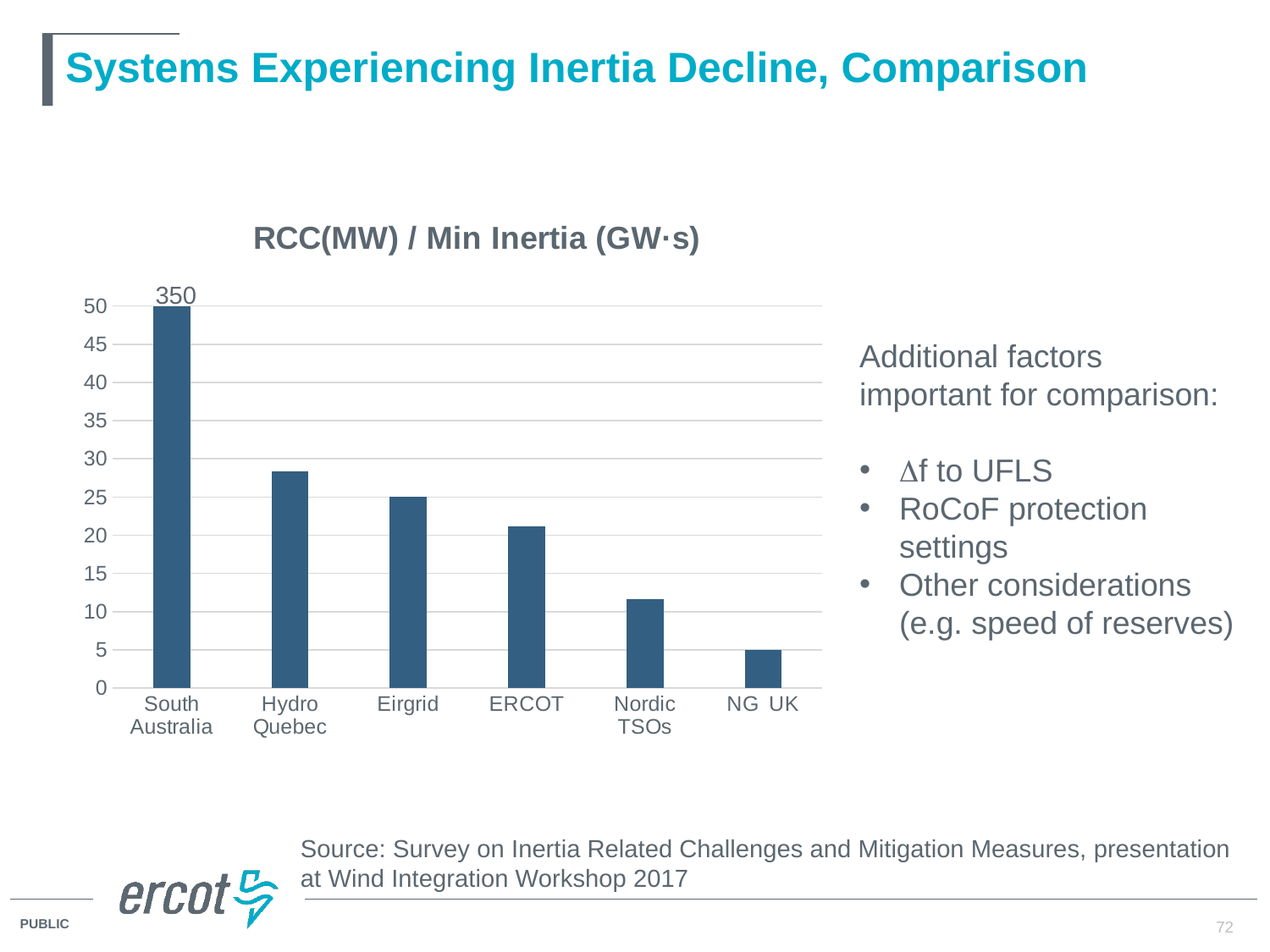
Which is larger, the value for Hydro Quebec or the value for ERCOT? Hydro Quebec What is the data label shown on the South Australia bar? 350 Do the values rise or fall from left to right across the chart? Fall What is the value for NG UK? 5 Is the value for ERCOT greater or less than 20? greater Which system has the highest RCC(MW) / Min Inertia value? South Australia What kind of chart is shown on the slide? Bar chart Is the value for Nordic TSOs greater or less than 10? greater How many systems are shown on the chart? 6 What is the value for Eirgrid? 25 Is the value for Hydro Quebec greater or less than 25? greater Which system has the lowest RCC(MW) / Min Inertia value? NG UK